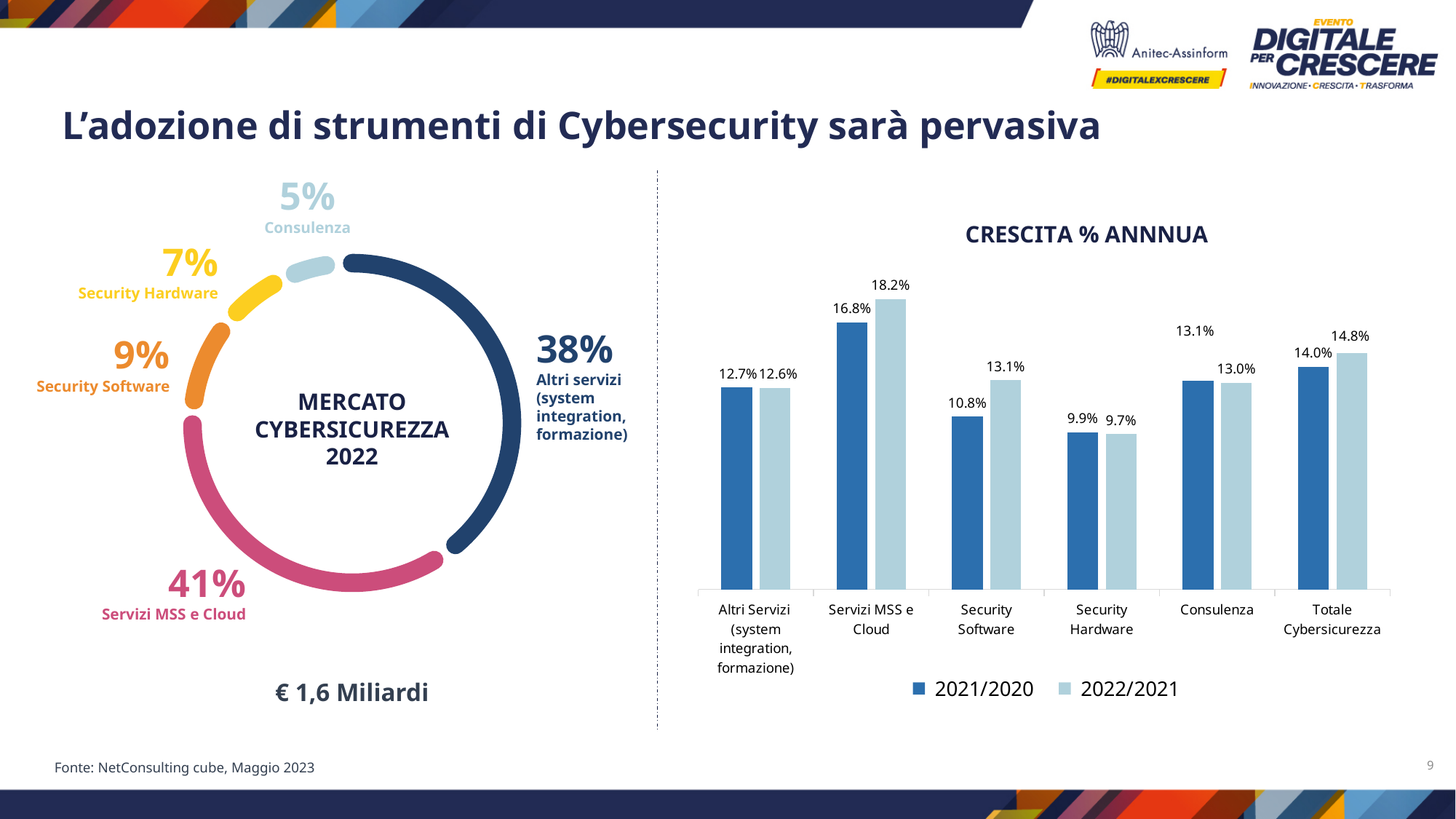
In the bar chart CRESCITA % ANNNUA, how many series does the legend list? 2 In the bar chart CRESCITA % ANNNUA, which is larger for Security Software: the 2021/2020 value or the 2022/2021 value? 2022/2021 In the bar chart CRESCITA % ANNNUA, which category has the lowest 2022/2021 value? Security Hardware In the bar chart CRESCITA % ANNNUA, what is the difference between the 2022/2021 and 2021/2020 values for Totale Cybersicurezza? 0.8% In the donut chart MERCATO CYBERSICUREZZA 2022, what is the difference between the Security Software share and the Security Hardware share? 2% In the donut chart MERCATO CYBERSICUREZZA 2022, which segment is the smallest? Consulenza What type of chart is the one titled CRESCITA % ANNNUA? Bar chart In the bar chart CRESCITA % ANNNUA, what is the 2022/2021 value for Servizi MSS e Cloud? 18.2% In the donut chart MERCATO CYBERSICUREZZA 2022, what share does Servizi MSS e Cloud hold? 41% In the bar chart CRESCITA % ANNNUA, what is the 2021/2020 value for Security Software? 10.8% In the donut chart MERCATO CYBERSICUREZZA 2022, which segment is the largest? Servizi MSS e Cloud In the donut chart MERCATO CYBERSICUREZZA 2022, how many segments are shown? 5